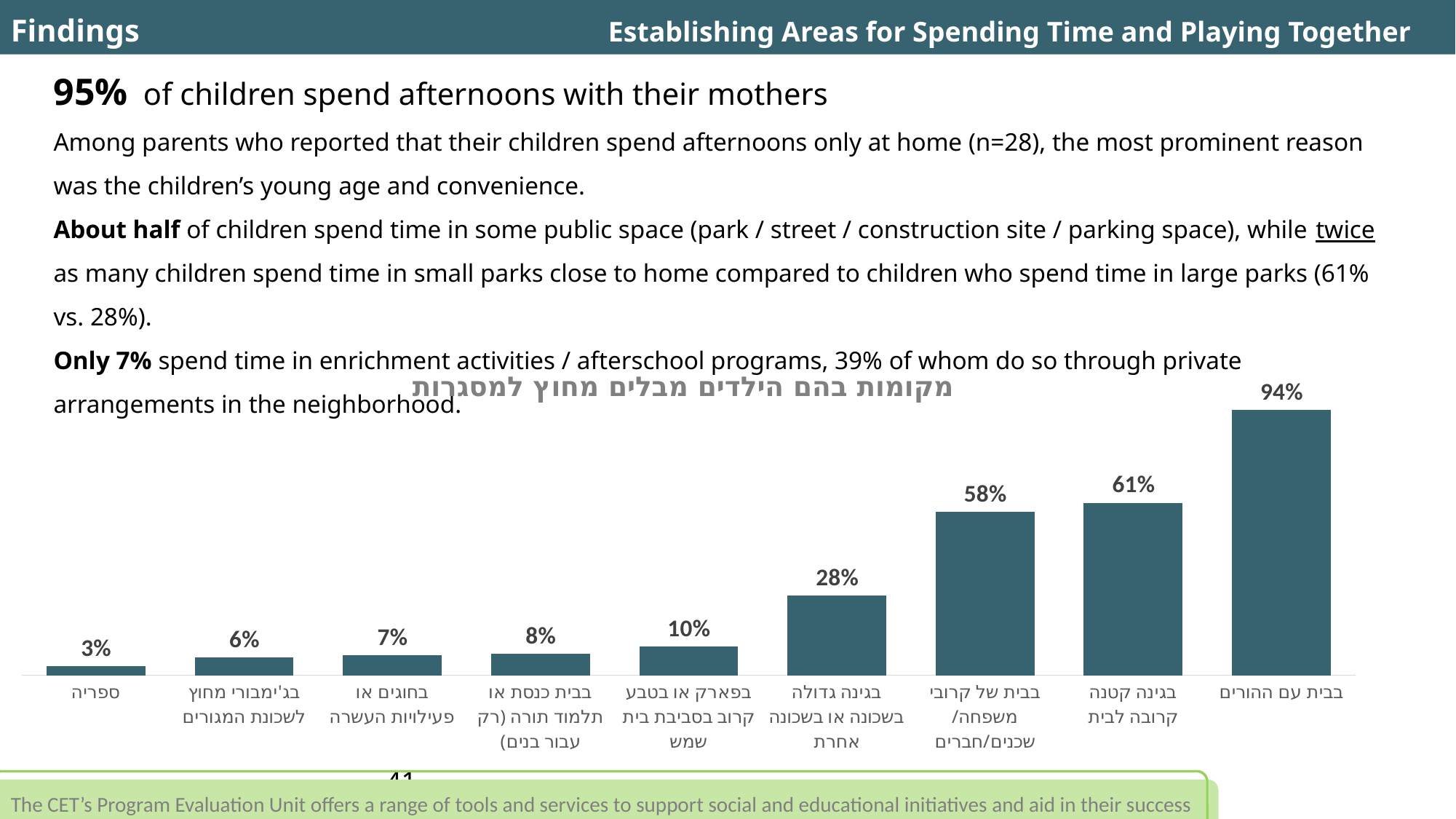
Which category has the highest value in the chart? בבית עם ההורים Which category has the lowest value in the chart? ספריה What is the value for בבית עם ההורים in the chart? 94% What kind of chart is shown on the slide? Bar chart What is the value for בבית של קרובי משפחה/שכנים/חברים? 58% What is the difference between the values for בגינה קטנה קרובה לבית and בגינה גדולה בשכונה או בשכונה אחרת? 33% What is the title of the chart? מקומות בהם הילדים מבלים מחוץ למסגרות How many categories are shown in the chart? 9 Do the bar values rise or fall from left to right across the chart? Rise What is the value for בגינה קטנה קרובה לבית? 61% Which is larger: the value for בפארק או בטבע קרוב בסביבת בית שמש or the value for בחוגים או פעילויות העשרה? בפארק או בטבע קרוב בסביבת בית שמש What is the value for ספריה in the chart? 3%